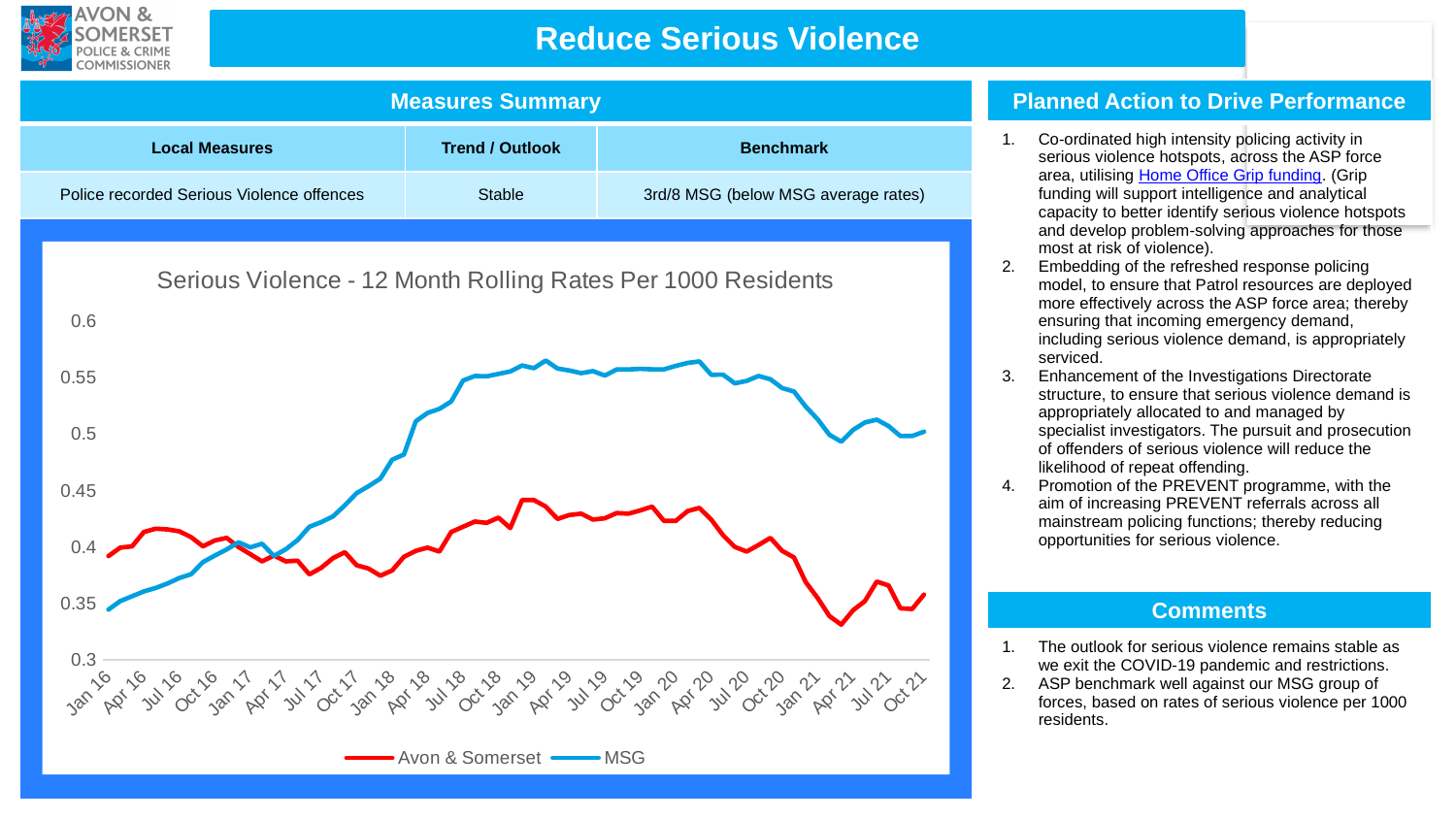
What kind of chart is shown on the slide? Line chart At Jan 19, which series has the higher value, Avon & Somerset or MSG? MSG Does the MSG line rise or fall between Jan 16 and Jan 19? rise Is the MSG value at Jan 19 greater or less than 0.55? greater At Jan 16, which series has the higher value, Avon & Somerset or MSG? Avon & Somerset Which series is drawn in blue on the chart? MSG Is the Avon & Somerset value at Jan 19 greater or less than 0.4? greater How many series does the chart legend list? 2 How many date labels are shown along the x axis of the chart? 24 What is the title of the chart? Serious Violence - 12 Month Rolling Rates Per 1000 Residents